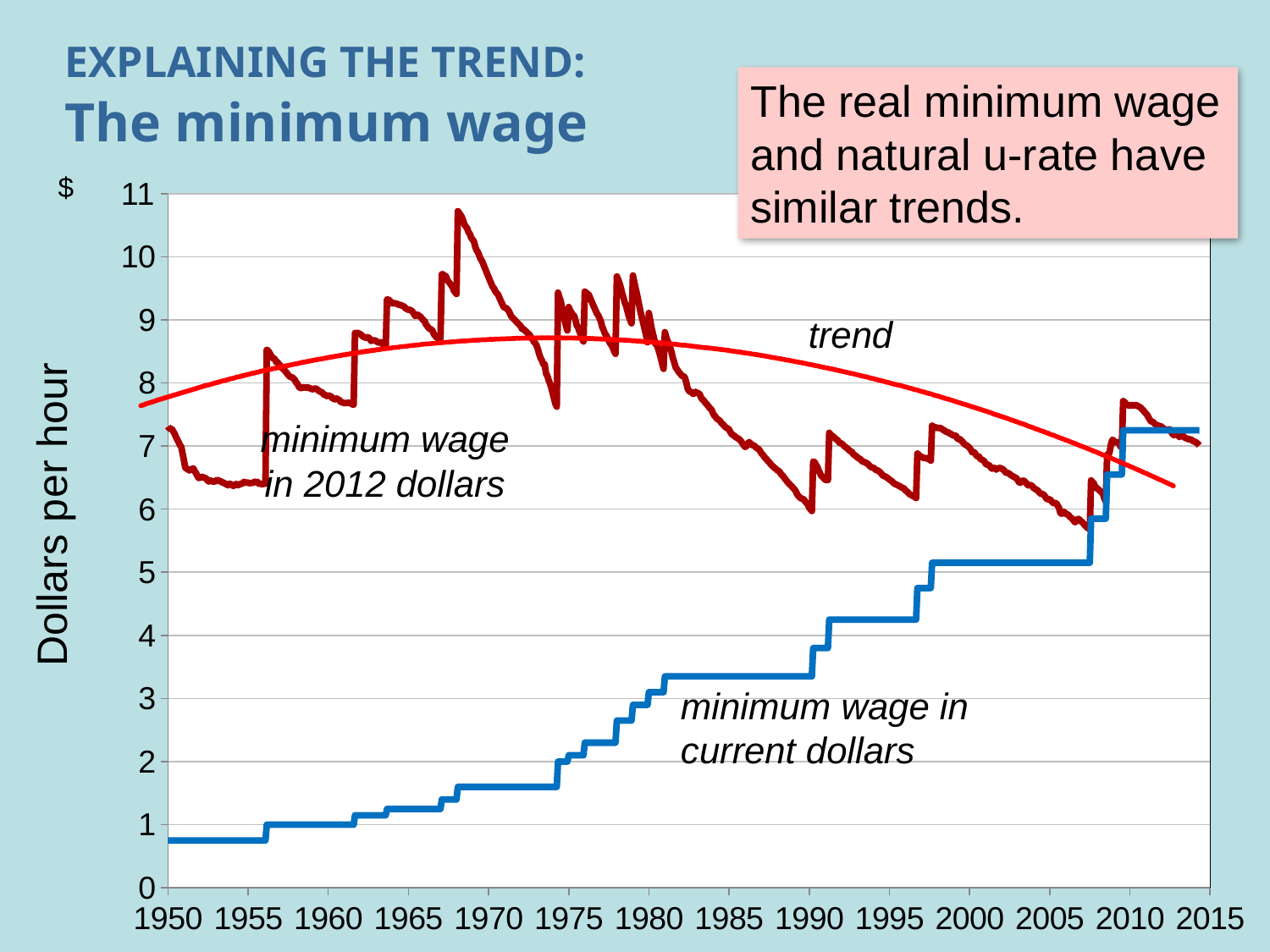
Is the peak value of the minimum wage in 2012 dollars around 1968 greater or less than 10? greater What is the label of the vertical axis? Dollars per hour What kind of chart is shown on the slide? line chart Is the value of the minimum wage in current dollars in 1950 greater or less than 1? less In 1970, which series is higher: minimum wage in 2012 dollars or minimum wage in current dollars? minimum wage in 2012 dollars Is the value of the minimum wage in current dollars in 1995 greater or less than 4? greater Does the minimum wage in current dollars rise or fall from 1950 to 2015? rise How many data series are labelled on the chart? 3 Does the trend line rise or fall between 1990 and 2015? fall